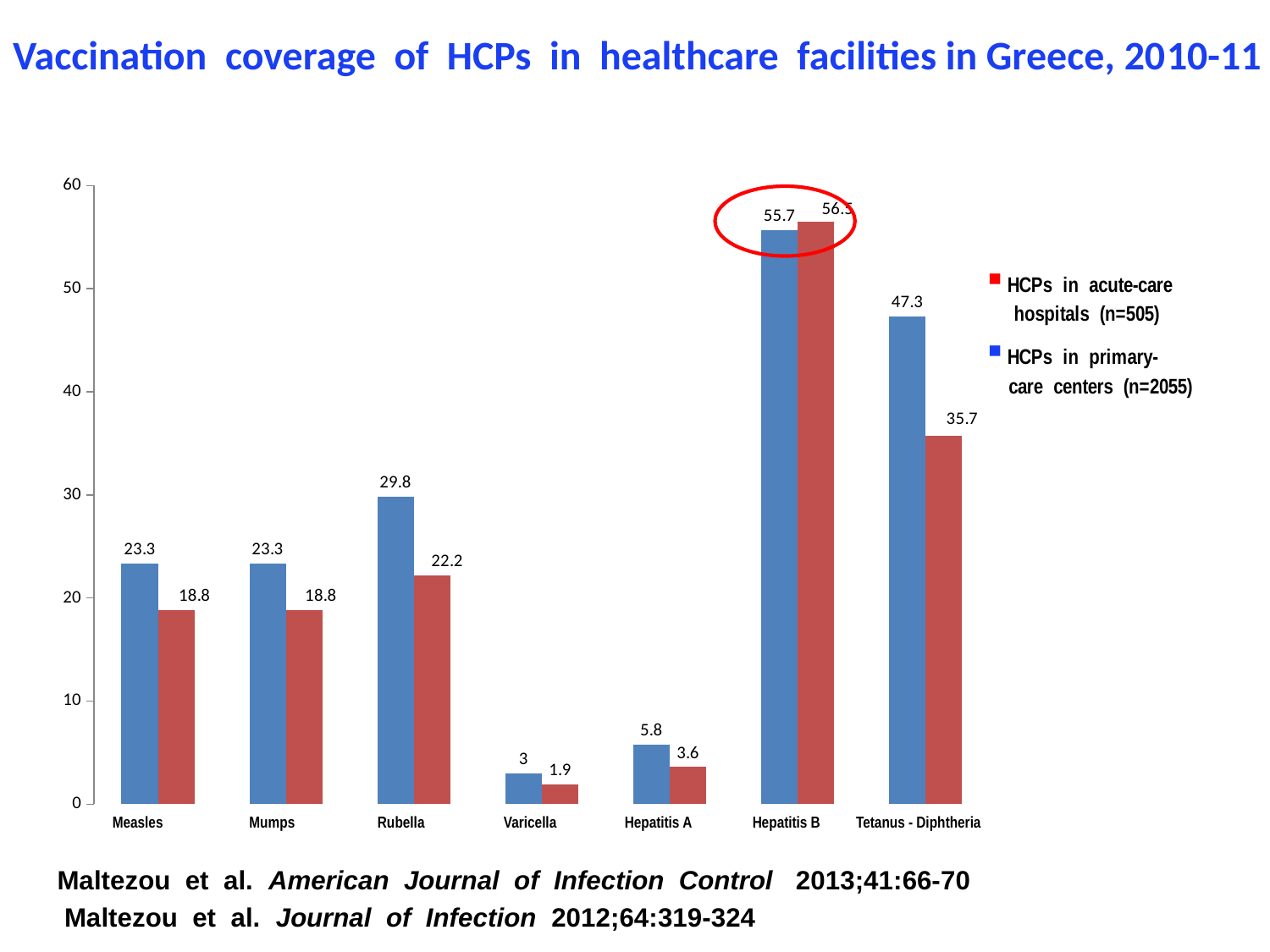
What kind of chart is shown on the slide? bar chart Which vaccine has the highest coverage among HCPs in primary-care centers (n=2055)? Hepatitis B Is the Tetanus - Diphtheria coverage for HCPs in primary-care centers greater or less than 40? greater How many series does the legend list? 2 Which vaccine has the lowest coverage among HCPs in acute-care hospitals (n=505)? Varicella What is the vaccination coverage for Rubella among HCPs in primary-care centers (n=2055)? 29.8 What is the vaccination coverage for Varicella among HCPs in acute-care hospitals (n=505)? 1.9 How many vaccines are shown on the x axis of the chart? 7 For Measles, which group has the higher vaccination coverage: HCPs in acute-care hospitals or HCPs in primary-care centers? HCPs in primary-care centers For Tetanus - Diphtheria, what is the difference between the coverage of HCPs in primary-care centers and HCPs in acute-care hospitals? 11.6 For Rubella, what is the difference between the coverage of HCPs in primary-care centers and HCPs in acute-care hospitals? 7.6 What is the vaccination coverage for Tetanus - Diphtheria among HCPs in acute-care hospitals (n=505)? 35.7